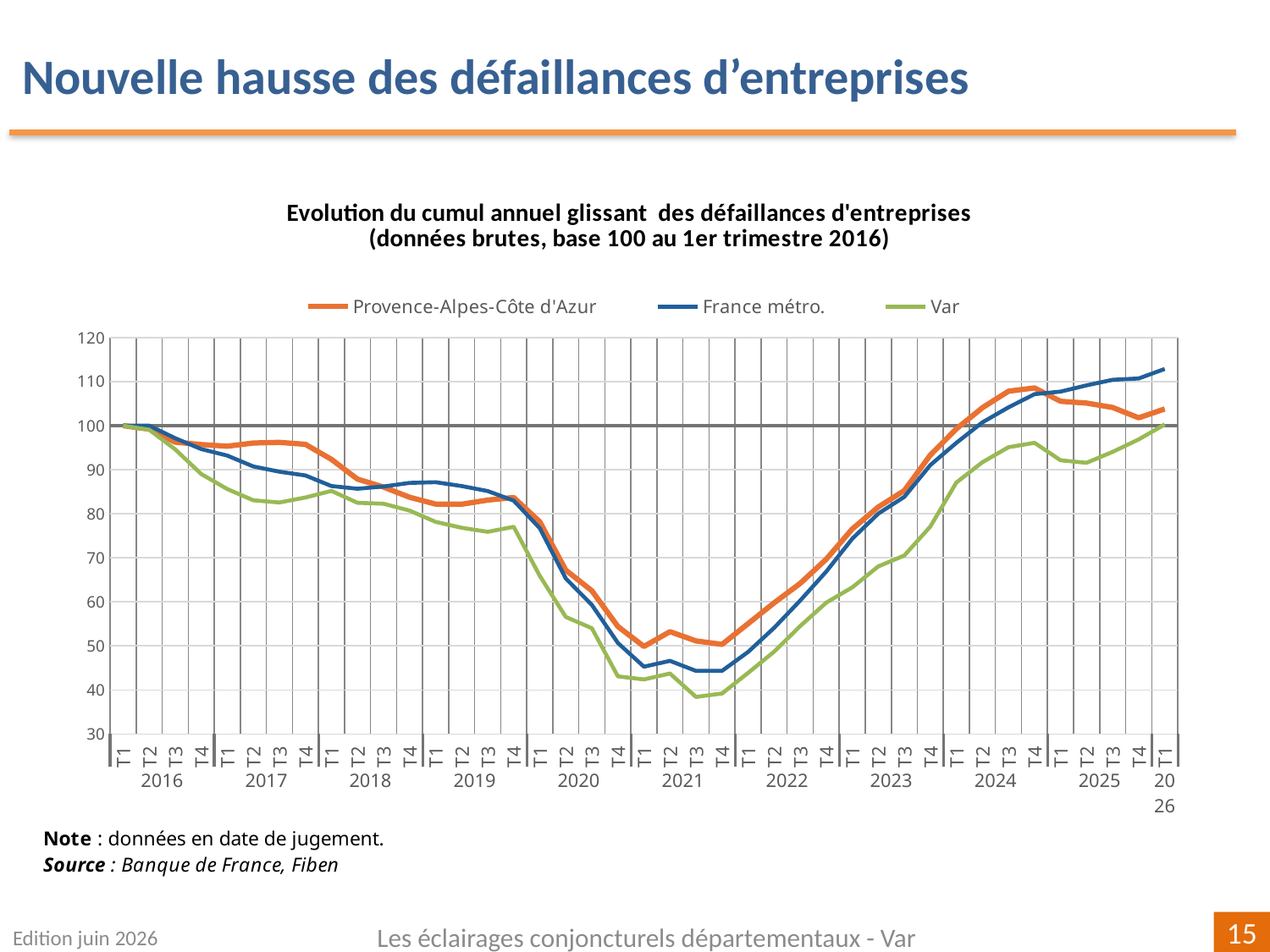
Do the values of the France métro. series rise or fall between T1 2022 and T1 2026? rise Which series has the highest value at T1 2026? France métro. Is the value for France métro. at T1 2026 greater or less than 110? greater Is the value for Var at T2 2025 greater or less than 100? less What kind of chart is shown on the slide? line chart Is the value for Var at T3 2021 greater or less than 50? less Which series has the lowest value at T3 2021? Var What is the title of the chart? Evolution du cumul annuel glissant des défaillances d'entreprises (données brutes, base 100 au 1er trimestre 2016) How many series does the legend list? 3 What is the value of the Var series at T1 2016? 100 Which three series are listed in the chart legend? Provence-Alpes-Côte d'Azur, France métro., Var